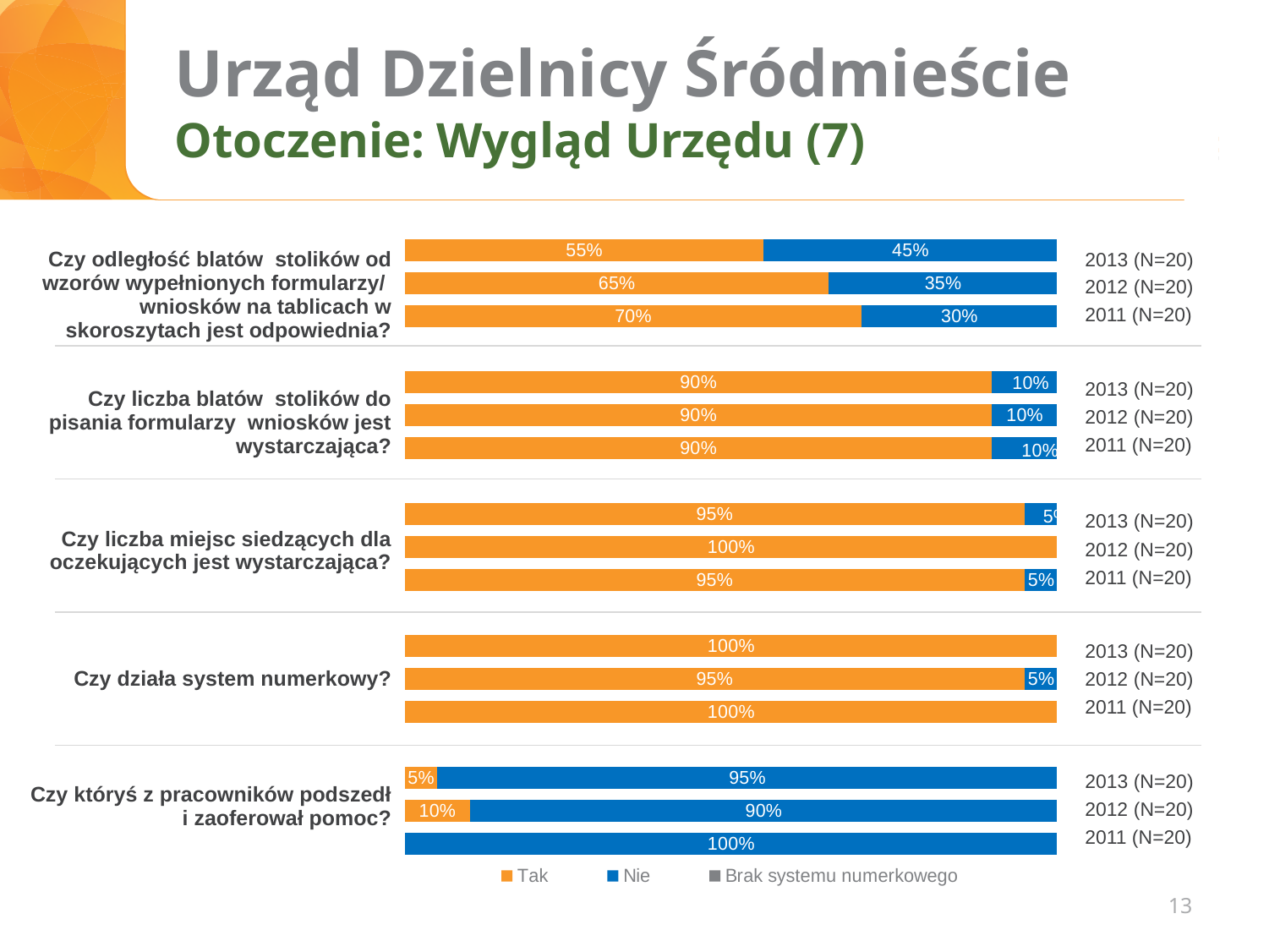
How many series does the legend at the bottom of the slide list? 3 In the chart for "Czy któryś z pracowników podszedł i zaoferował pomoc?", what is the "Nie" value for 2011 (N=20)? 100% In the chart for "Czy odległość blatów stolików od wzorów wypełnionych formularzy/wniosków na tablicach w skoroszytach jest odpowiednia?", what is the difference between the "Tak" values for 2011 and 2013? 15% In the chart for "Czy działa system numerkowy?", what is the "Nie" value for 2012 (N=20)? 5% In the chart for "Czy odległość blatów stolików od wzorów wypełnionych formularzy/wniosków na tablicach w skoroszytach jest odpowiednia?", which year has the highest "Tak" share? 2011 (N=20) In the chart for "Czy liczba miejsc siedzących dla oczekujących jest wystarczająca?", what is the "Tak" value for 2012 (N=20)? 100% In the chart for "Czy odległość blatów stolików od wzorów wypełnionych formularzy/wniosków na tablicach w skoroszytach jest odpowiednia?", what is the "Nie" value for 2011 (N=20)? 30% In the chart for "Czy liczba blatów stolików do pisania formularzy wniosków jest wystarczająca?", what is the "Tak" value for 2012 (N=20)? 90% In the chart for "Czy któryś z pracowników podszedł i zaoferował pomoc?", which is larger for 2012 (N=20): the "Tak" share or the "Nie" share? Nie In the chart for "Czy odległość blatów stolików od wzorów wypełnionych formularzy/wniosków na tablicach w skoroszytach jest odpowiednia?", does the "Tak" share rise or fall from 2011 to 2013? fall In the chart for "Czy odległość blatów stolików od wzorów wypełnionych formularzy/wniosków na tablicach w skoroszytach jest odpowiednia?", what is the "Tak" value for 2013 (N=20)? 55% What kind of chart is used on this slide? stacked bar chart